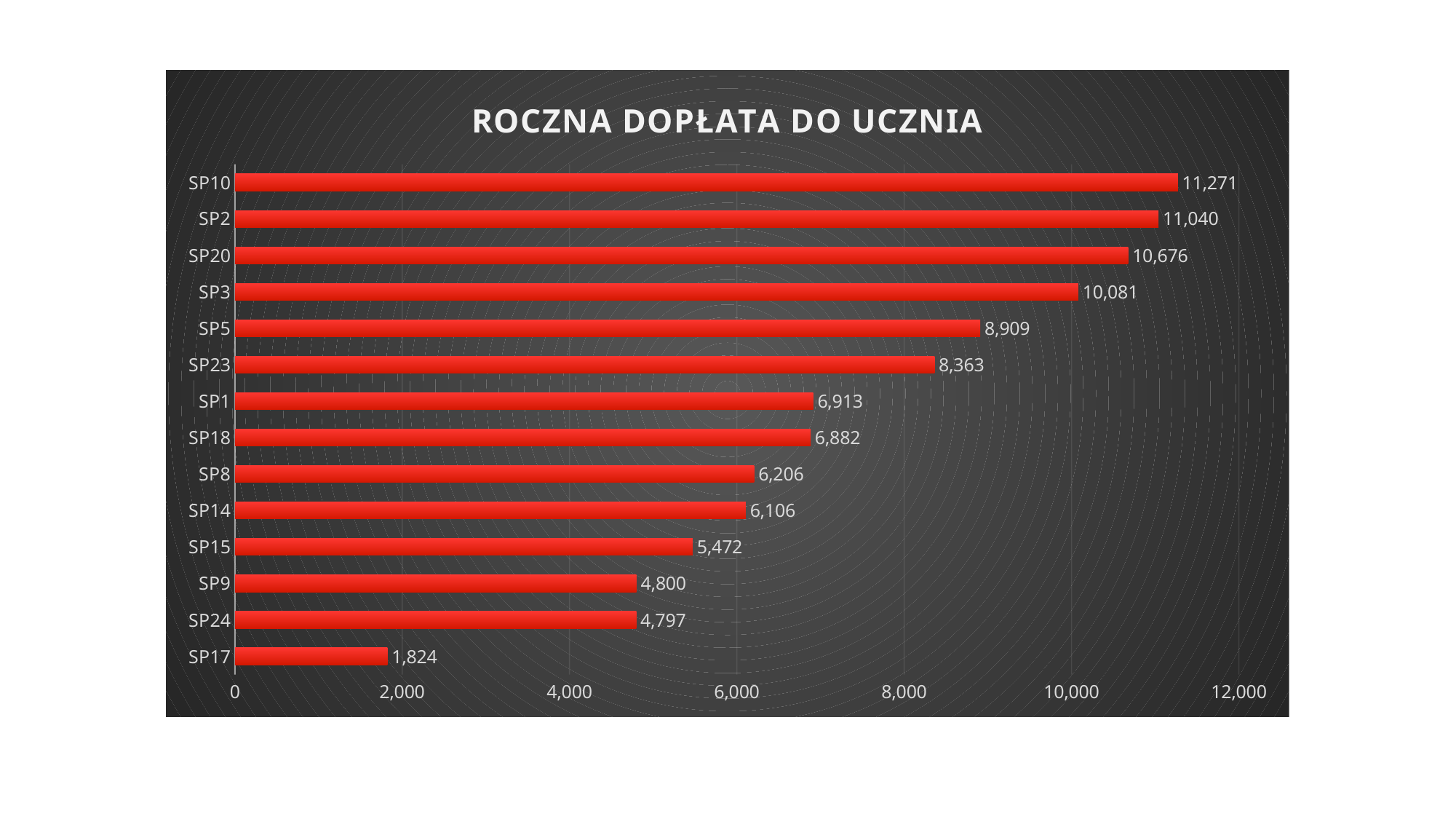
What kind of chart is shown on the slide? bar chart Which is larger, the value for SP3 or the value for SP5? SP3 What is the title of the chart? ROCZNA DOPŁATA DO UCZNIA Which category has the lowest value? SP17 What is the difference between the values for SP5 and SP23? 546 What is the value for SP23? 8,363 What is the difference between the values for SP10 and SP2? 231 How many categories are shown in the chart? 14 Is the value for SP15 greater or less than 6,000? less Which category has the highest value? SP10 What is the value for SP17? 1,824 What is the value for SP10? 11,271